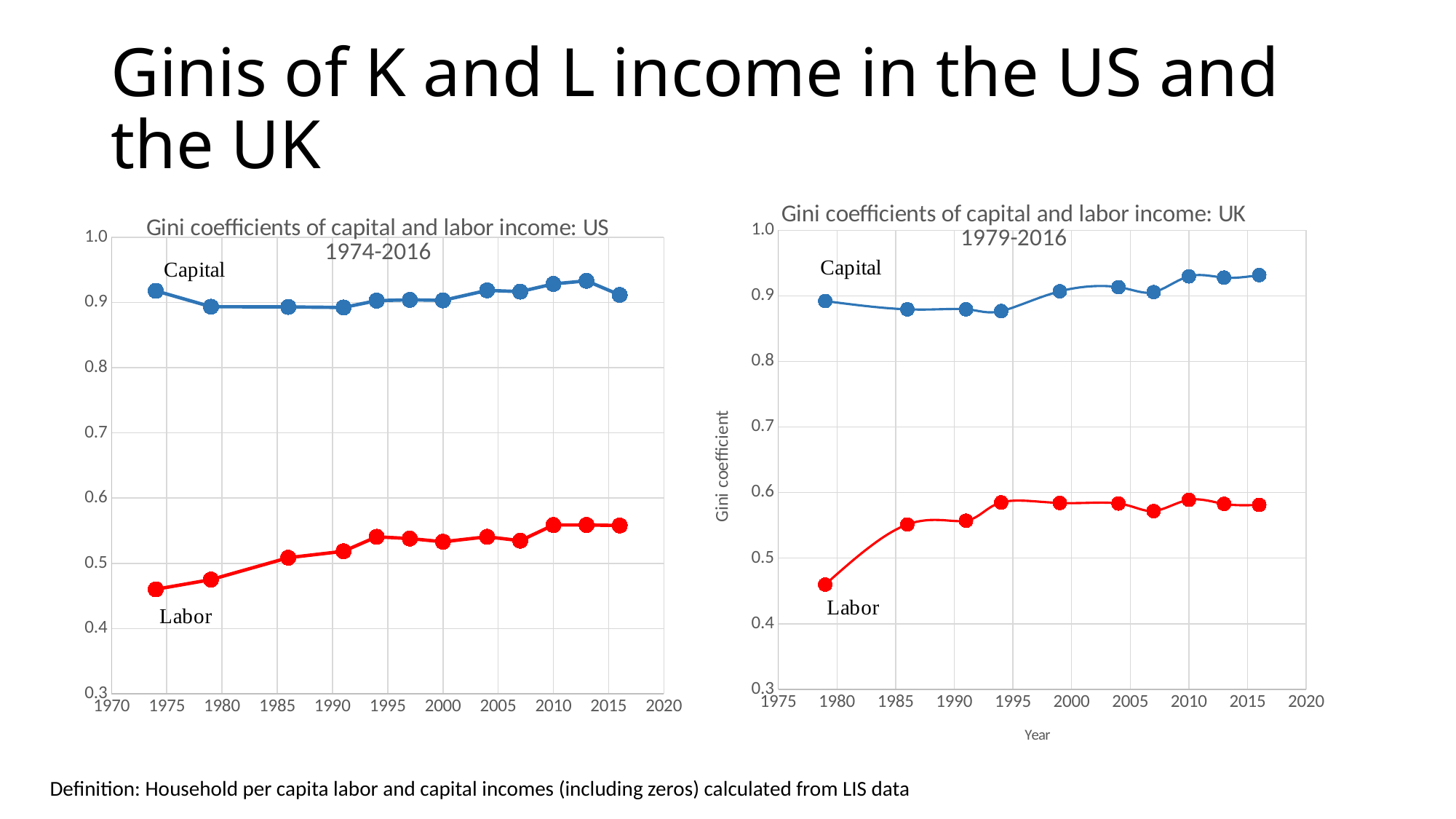
What is the y-axis label on the UK chart? Gini coefficient In the US chart, which series has the higher values throughout, Capital or Labor? Capital In the UK chart, is the Capital value for 1994 greater or less than 0.9? less In the US chart, does the Labor series generally rise or fall from 1974 to 2016? rise In the UK chart, is the Labor value for 1979 greater or less than 0.5? less In the UK chart, what are the two series labelled? Capital and Labor In the US chart, is the Labor value for 1974 greater or less than 0.5? less In the US chart, how many series are plotted? 2 What kind of chart is the 'Gini coefficients of capital and labor income: US 1974-2016' chart? line chart In the UK chart, how many data points are plotted for the Labor series? 10